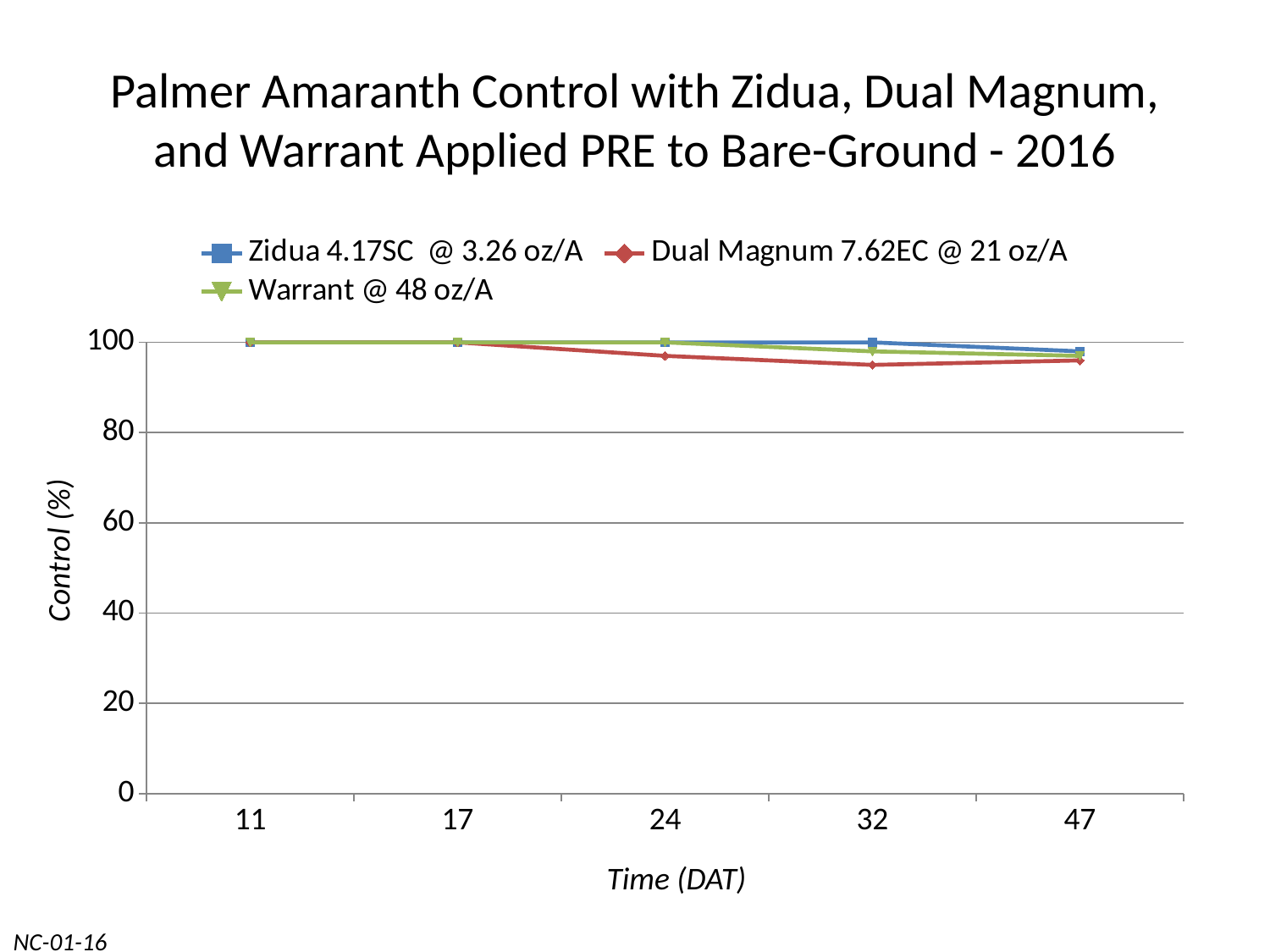
What is the label of the x axis? Time (DAT) What is the control value for Zidua 4.17SC @ 3.26 oz/A at 11 DAT? 100 What is the control value for Dual Magnum 7.62EC @ 21 oz/A at 17 DAT? 100 Which series has the lowest control value at 32 DAT? Dual Magnum 7.62EC @ 21 oz/A What is the label of the y axis? Control (%) What kind of chart is shown on the slide? line chart How many time points are plotted along the x axis? 5 How many series does the legend list? 3 Does the Dual Magnum 7.62EC @ 21 oz/A line rise or fall from 17 DAT to 32 DAT? fall At 24 DAT, which is larger: the value for Zidua 4.17SC @ 3.26 oz/A or for Dual Magnum 7.62EC @ 21 oz/A? Zidua 4.17SC @ 3.26 oz/A Is the value for Dual Magnum 7.62EC @ 21 oz/A at 32 DAT greater or less than 80? greater